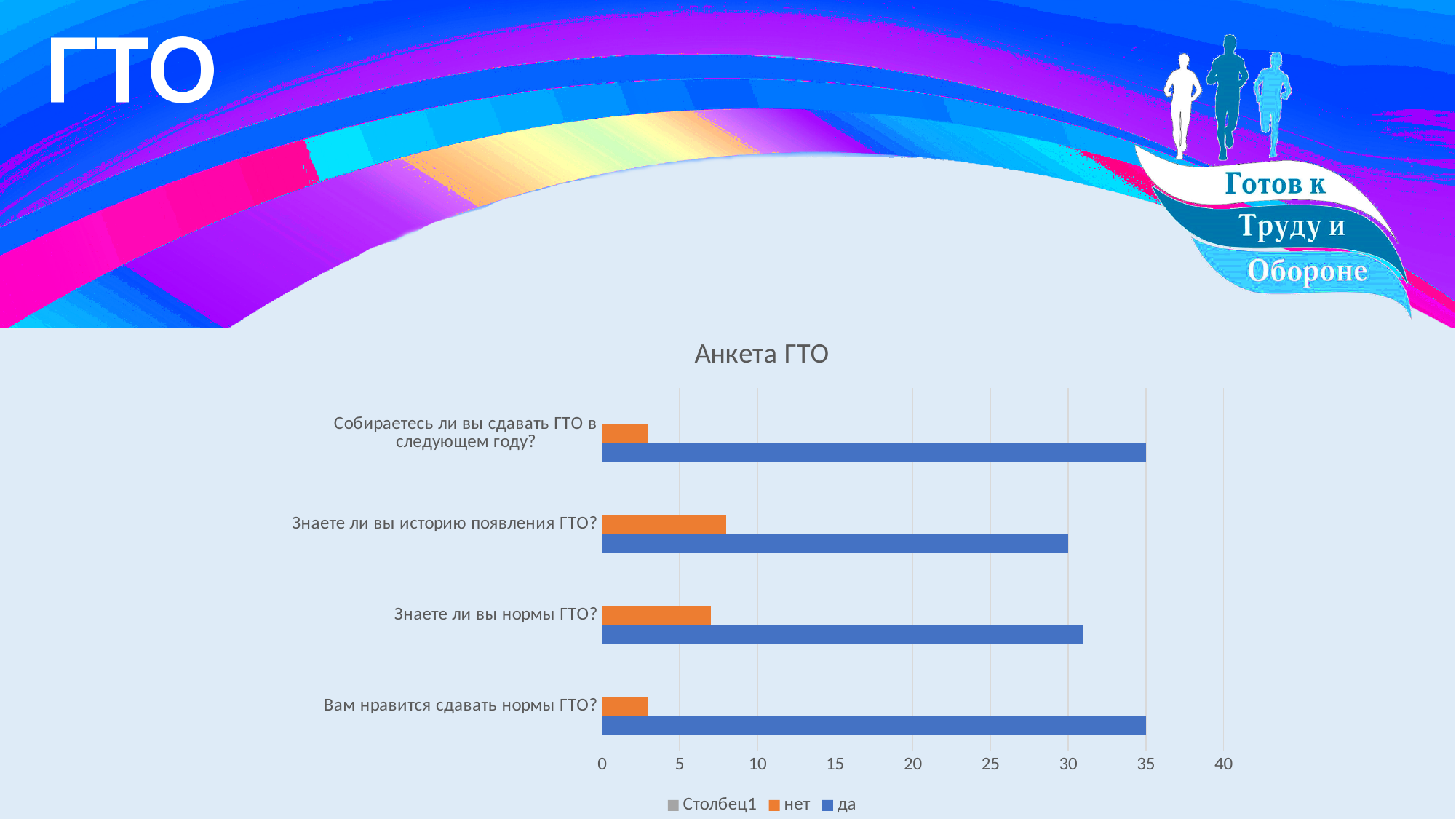
What is the value of the "да" bar for "Вам нравится сдавать нормы ГТО?"? 35 How many question categories are plotted on the chart? 4 How many series does the chart legend list? 3 Is the "да" value for "Знаете ли вы нормы ГТО?" greater or less than 30? greater Is the "нет" value for "Вам нравится сдавать нормы ГТО?" greater or less than 5? less Is the "нет" value for "Знаете ли вы историю появления ГТО?" greater or less than 10? less What is the value of the "да" bar for "Собираетесь ли вы сдавать ГТО в следующем году?"? 35 What is the title of the chart? Анкета ГТО For "Знаете ли вы нормы ГТО?", which is larger, the "да" bar or the "нет" bar? да Which category has the lowest "да" value? Знаете ли вы историю появления ГТО? What is the value of the "да" bar for "Знаете ли вы историю появления ГТО?"? 30 What kind of chart is shown on the slide? bar chart